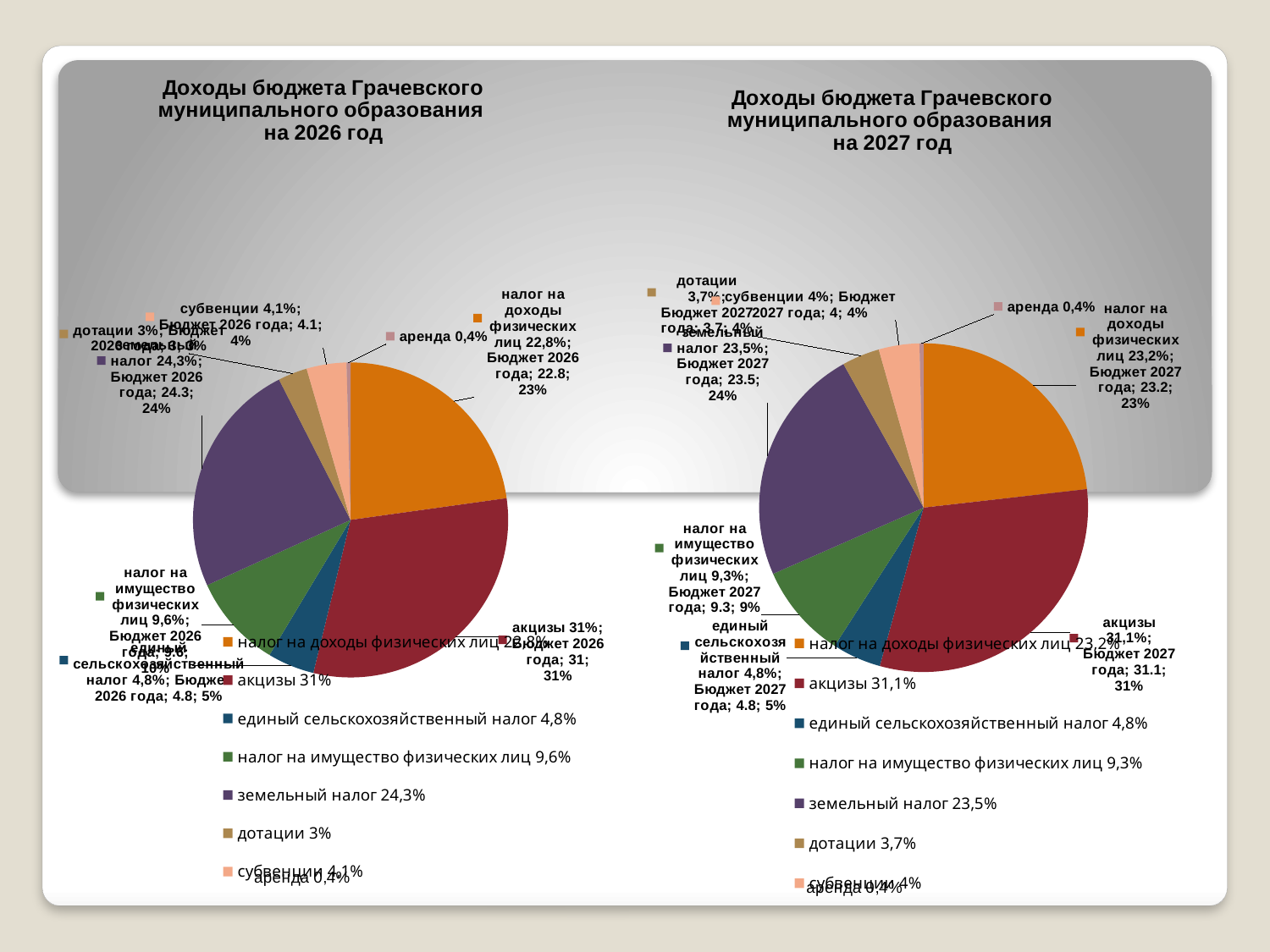
In the 2026 chart, what share is shown for субвенции? 4,1% What is the title of the chart on the right side of the slide? Доходы бюджета Грачевского муниципального образования на 2027 год In the 2027 chart, which is larger: the share of налог на имущество физических лиц or the share of единый сельскохозяйственный налог? налог на имущество физических лиц In the 2026 chart, which category has the largest share? акцизы In the 2027 chart, what share is shown for налог на доходы физических лиц? 23,2% In the 2026 chart, what is the difference between the shares of земельный налог and налог на доходы физических лиц? 1,5% In the 2026 chart, what share is shown for акцизы? 31% In the 2026 chart, what share is shown for земельный налог? 24,3% What type of chart is used on the slide for 'Доходы бюджета Грачевского муниципального образования на 2026 год'? pie chart In the 2027 chart, what share is shown for дотации? 3,7% In the 2027 chart, which category has the smallest share? аренда How many categories does the legend of the 2027 chart list? 8